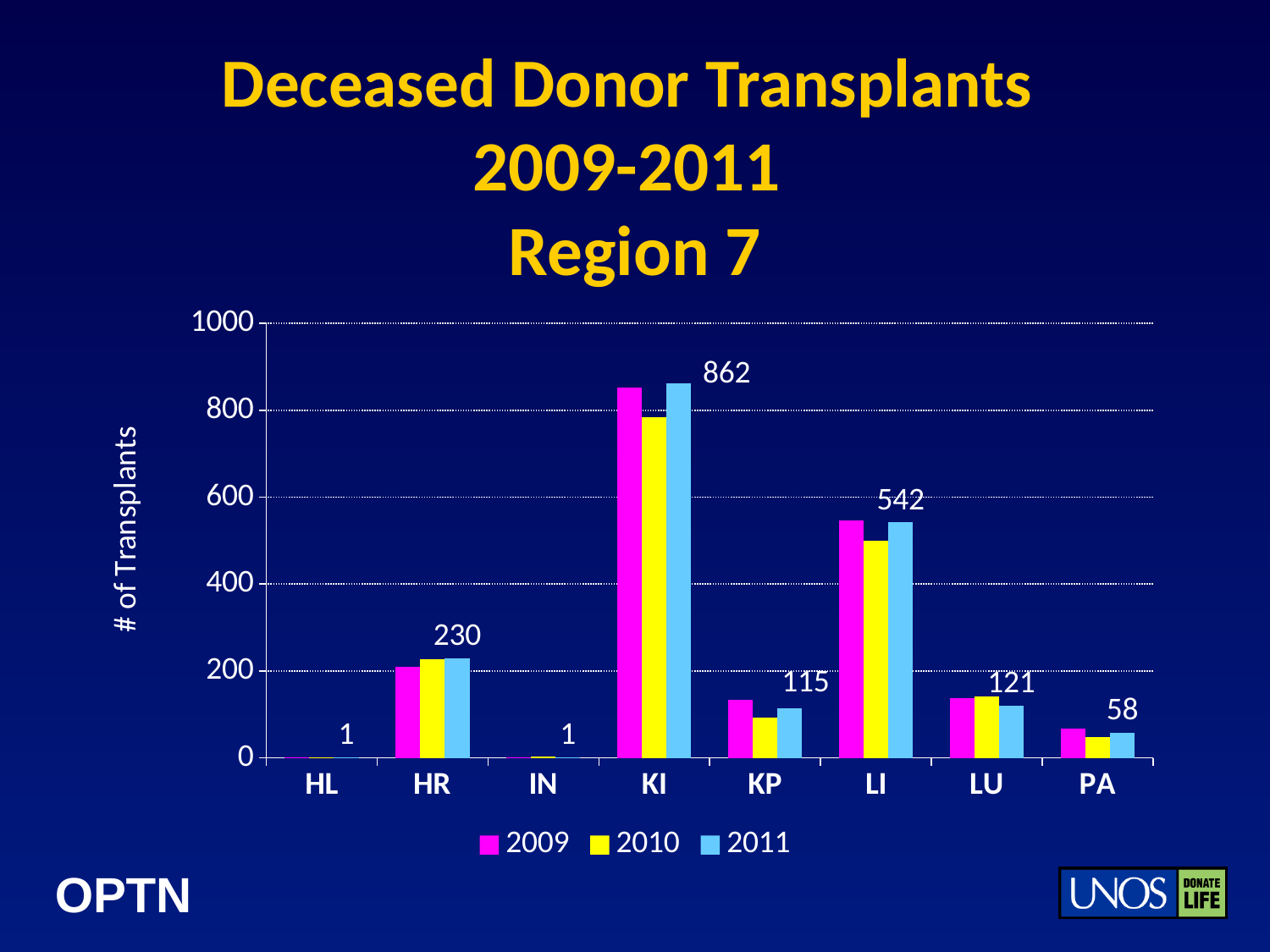
Which is larger in 2011, KP or LU? LU What is the label on the y axis? # of Transplants Which category has the highest number of transplants in 2011? KI What is the 2011 value for LI? 542 What is the difference between the 2011 values for KI and LI? 320 How many series does the legend list? 3 Is the 2009 value for KI greater or less than 800? greater What is the 2011 value for PA? 58 What is the 2011 value for KI? 862 What is the 2011 value for HR? 230 What type of chart is shown on the slide? bar chart How many organ categories are shown on the x axis? 8